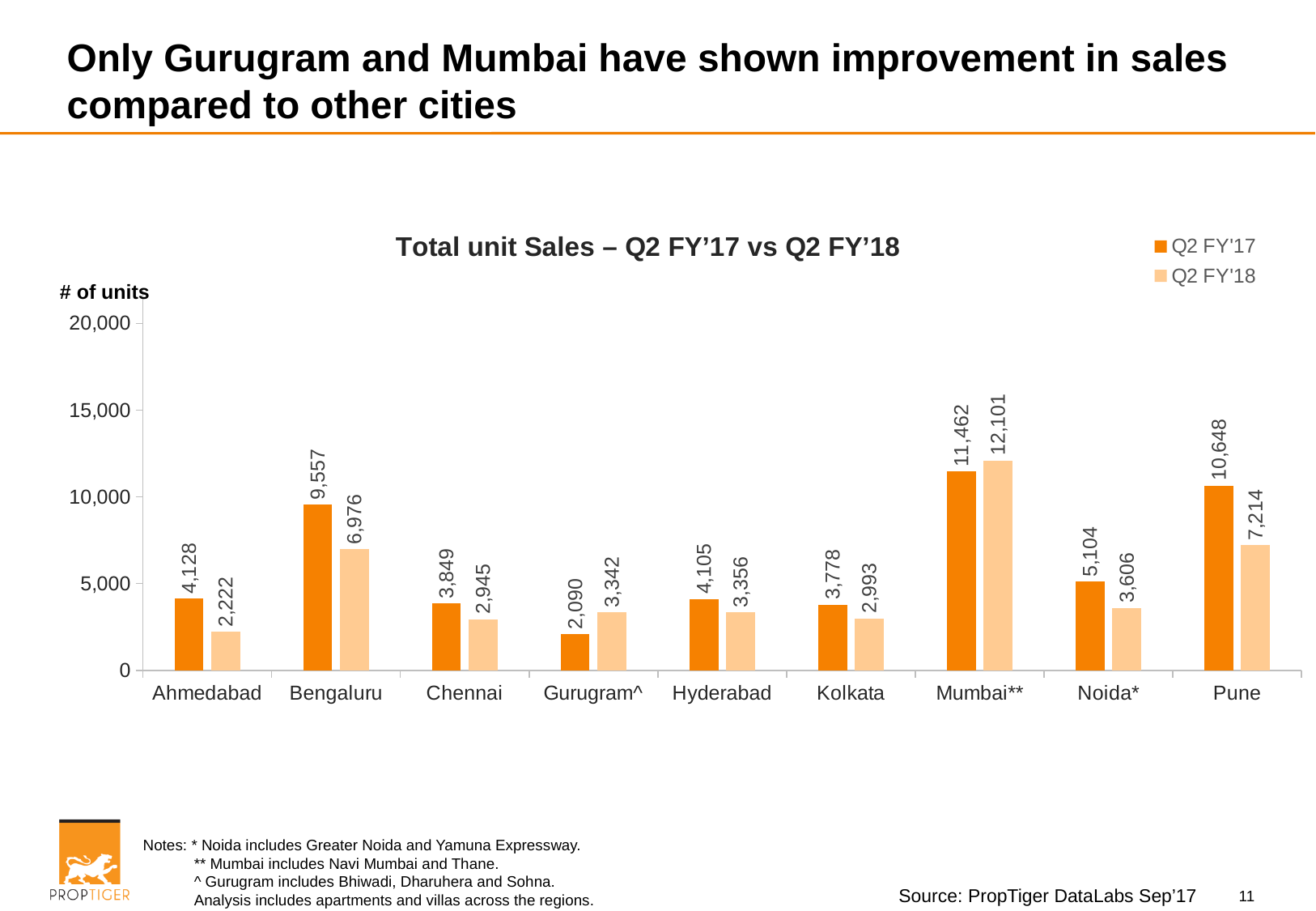
How many cities are shown on the x axis? 9 What is the title of the chart? Total unit Sales – Q2 FY'17 vs Q2 FY'18 Which city has the highest Q2 FY'18 value? Mumbai** What is the Q2 FY'17 value for Bengaluru? 9,557 Which is larger for Noida*: the Q2 FY'17 value or the Q2 FY'18 value? Q2 FY'17 What is the Q2 FY'18 value for Mumbai**? 12,101 How many series does the legend list? 2 What is the difference between the Q2 FY'17 and Q2 FY'18 values for Pune? 3,434 Is the Q2 FY'17 value for Pune greater or less than 10,000? greater Which city has the lowest Q2 FY'17 value? Gurugram^ What kind of chart is shown on the slide? bar chart What is the Q2 FY'18 value for Gurugram^? 3,342